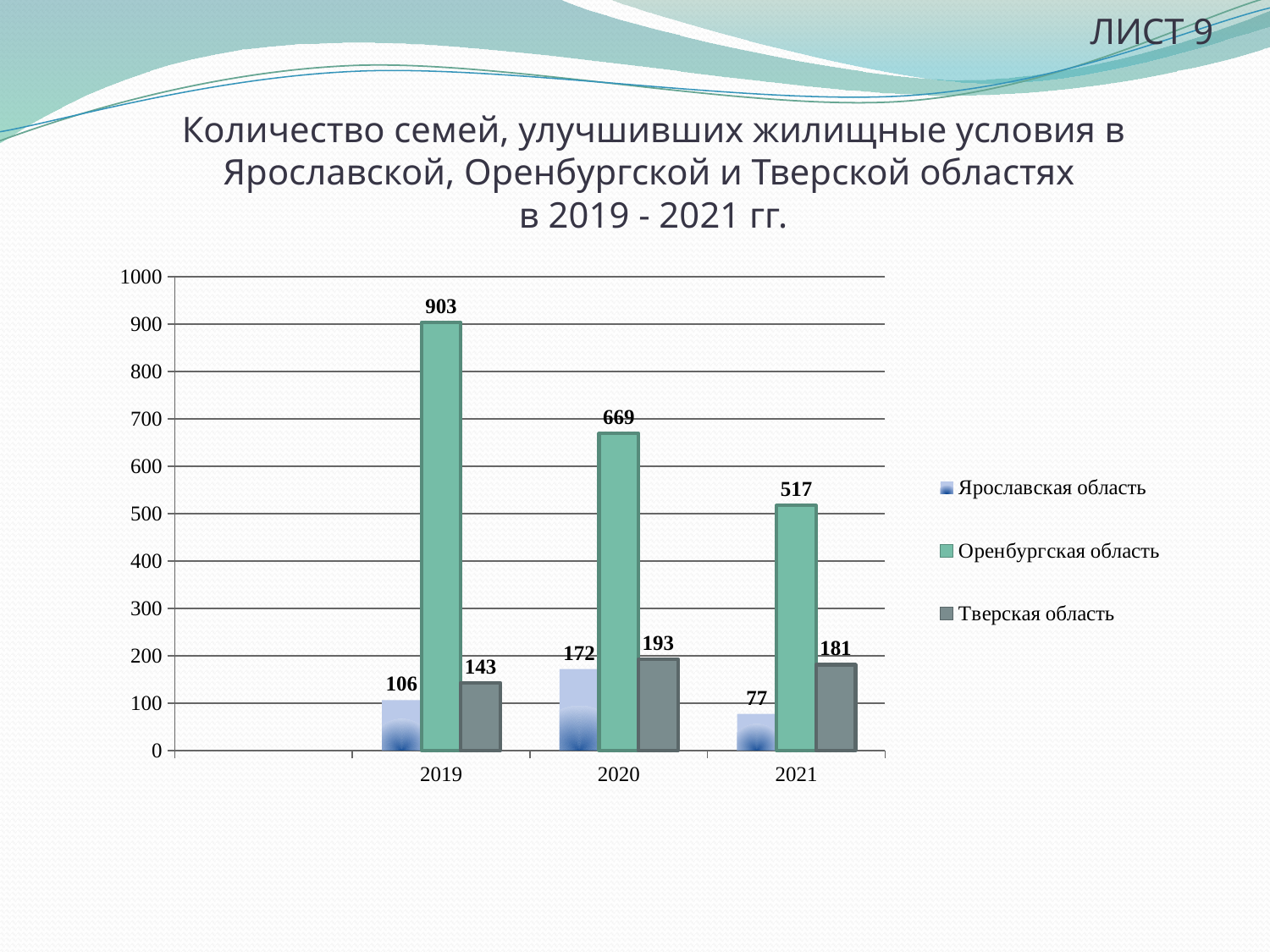
What is the value for Тверская область in 2020? 193 Which is larger in 2020: Ярославская область or Тверская область? Тверская область Does the value for Оренбургская область rise or fall from 2019 to 2021? fall In which year is the value for Ярославская область lowest? 2021 What is the difference between the Тверская область and Ярославская область values in 2021? 104 Is the value for Оренбургская область in 2021 greater or less than 500? greater What is the difference between the Оренбургская область values for 2019 and 2020? 234 What is the value for Оренбургская область in 2019? 903 How many series does the legend list? 3 What is the value for Ярославская область in 2021? 77 In which year is the value for Оренбургская область highest? 2019 How many years are shown on the x axis? 3